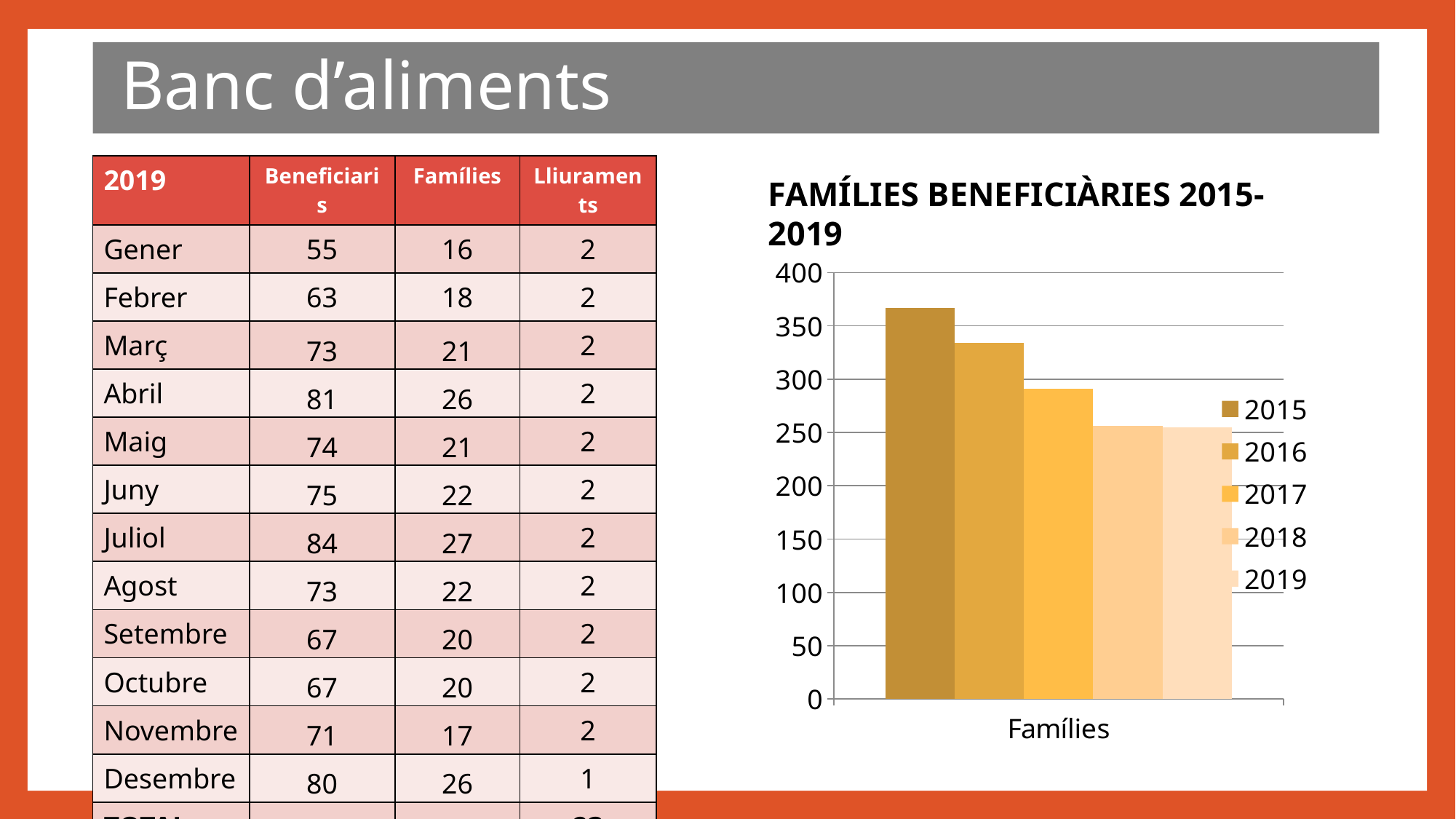
What is the title of the chart? FAMÍLIES BENEFICIÀRIES 2015-2019 How many categories are shown on the x axis of the chart? 1 Which year has the highest number of families in the chart? 2015 Is the value for 2016 greater or less than 350? less What kind of chart is shown on the slide? bar chart Is the value for 2015 greater or less than 350? greater How many series does the chart legend list? 5 Do the values rise or fall from 2015 to 2019 in the chart? fall Is the value for 2018 greater or less than 300? less Which is larger, the value for 2016 or the value for 2017? 2016 What is the label of the category on the x axis of the chart? Famílies